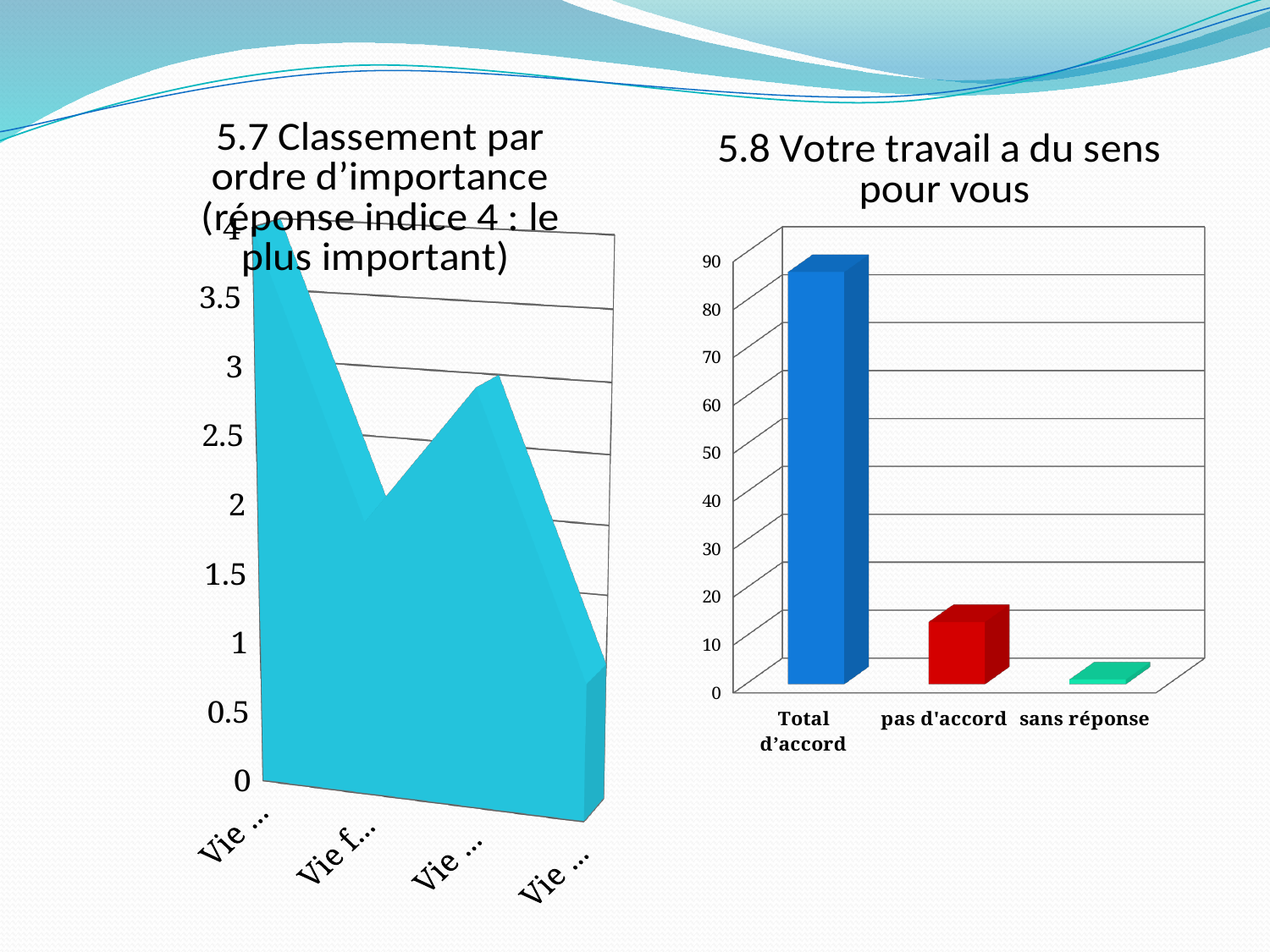
In the chart '5.8 Votre travail a du sens pour vous', is the value for sans réponse greater or less than 10? less In the chart '5.8 Votre travail a du sens pour vous', what colour is the bar for Total d'accord? blue In the chart '5.8 Votre travail a du sens pour vous', which category has the lowest value? sans réponse In the chart '5.8 Votre travail a du sens pour vous', which category has the highest value? Total d'accord What kind of chart is the chart titled '5.8 Votre travail a du sens pour vous'? bar chart In the chart '5.8 Votre travail a du sens pour vous', how many categories are shown on the x axis? 3 In the chart '5.8 Votre travail a du sens pour vous', which is larger, the value for pas d'accord or the value for sans réponse? pas d'accord In the chart on the left of the slide (5.7 Classement par ordre d'importance), how many data points are plotted? 4 In the chart '5.8 Votre travail a du sens pour vous', is the value for pas d'accord greater or less than 20? less What kind of chart is the chart on the left of the slide (5.7 Classement par ordre d'importance)? area chart In the chart '5.8 Votre travail a du sens pour vous', is the value for Total d'accord greater or less than 80? greater What is the title of the chart on the right of the slide? 5.8 Votre travail a du sens pour vous